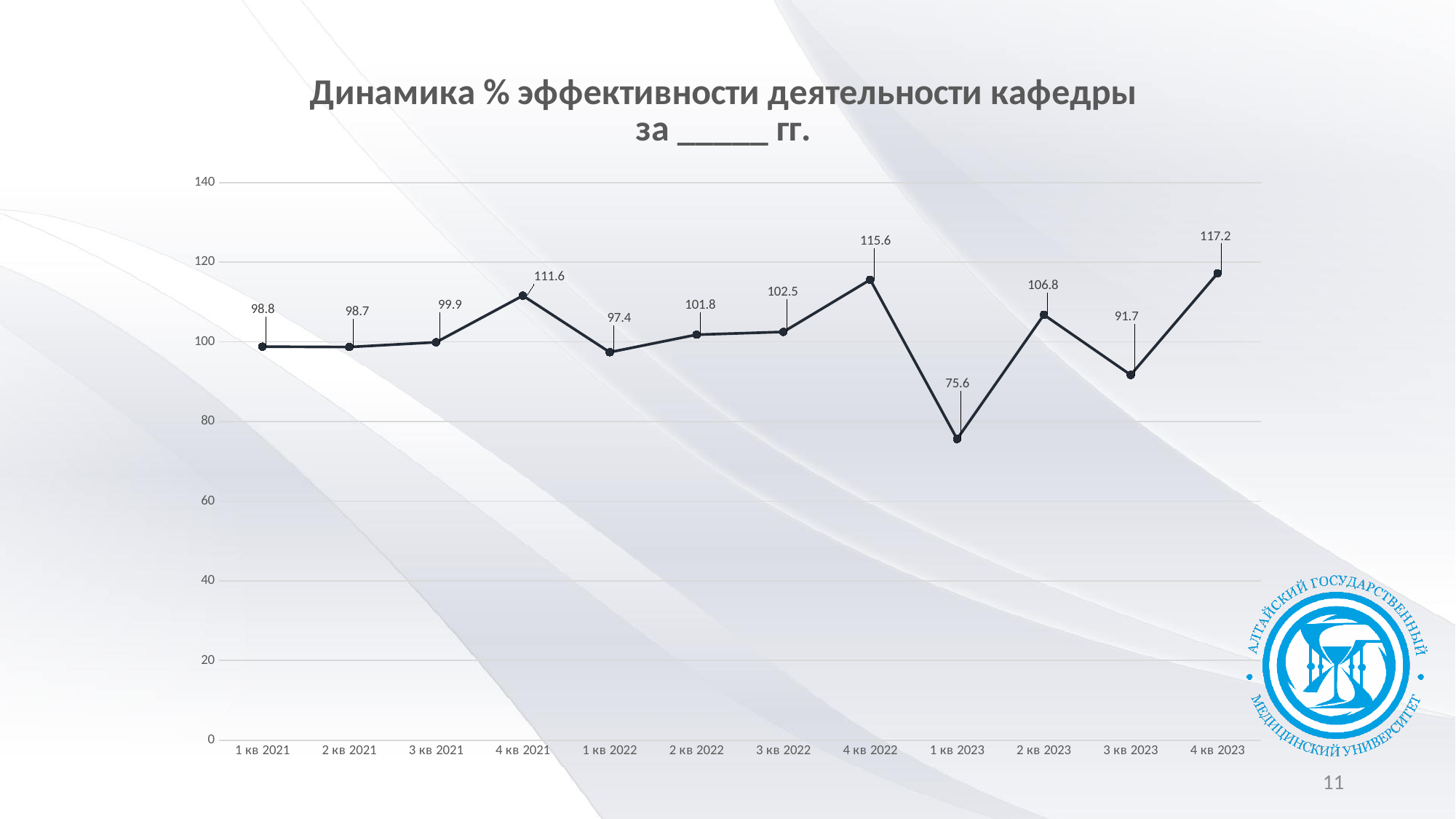
Which quarter has the lowest value? 1 кв 2023 Which is larger, the value for 4 кв 2021 or the value for 2 кв 2023? 4 кв 2021 What is the value for 3 кв 2021? 99.9 Which quarter has the highest value? 4 кв 2023 Is the value for 3 кв 2023 greater or less than 100? less What is the highest tick value shown on the y axis? 140 Does the value rise or fall from 4 кв 2022 to 1 кв 2023? fall How many quarters are plotted on the x axis? 12 What kind of chart is shown on the slide? line chart What is the difference between the values for 4 кв 2023 and 1 кв 2023? 41.6 What is the value for 4 кв 2022? 115.6 What is the value for 1 кв 2023? 75.6